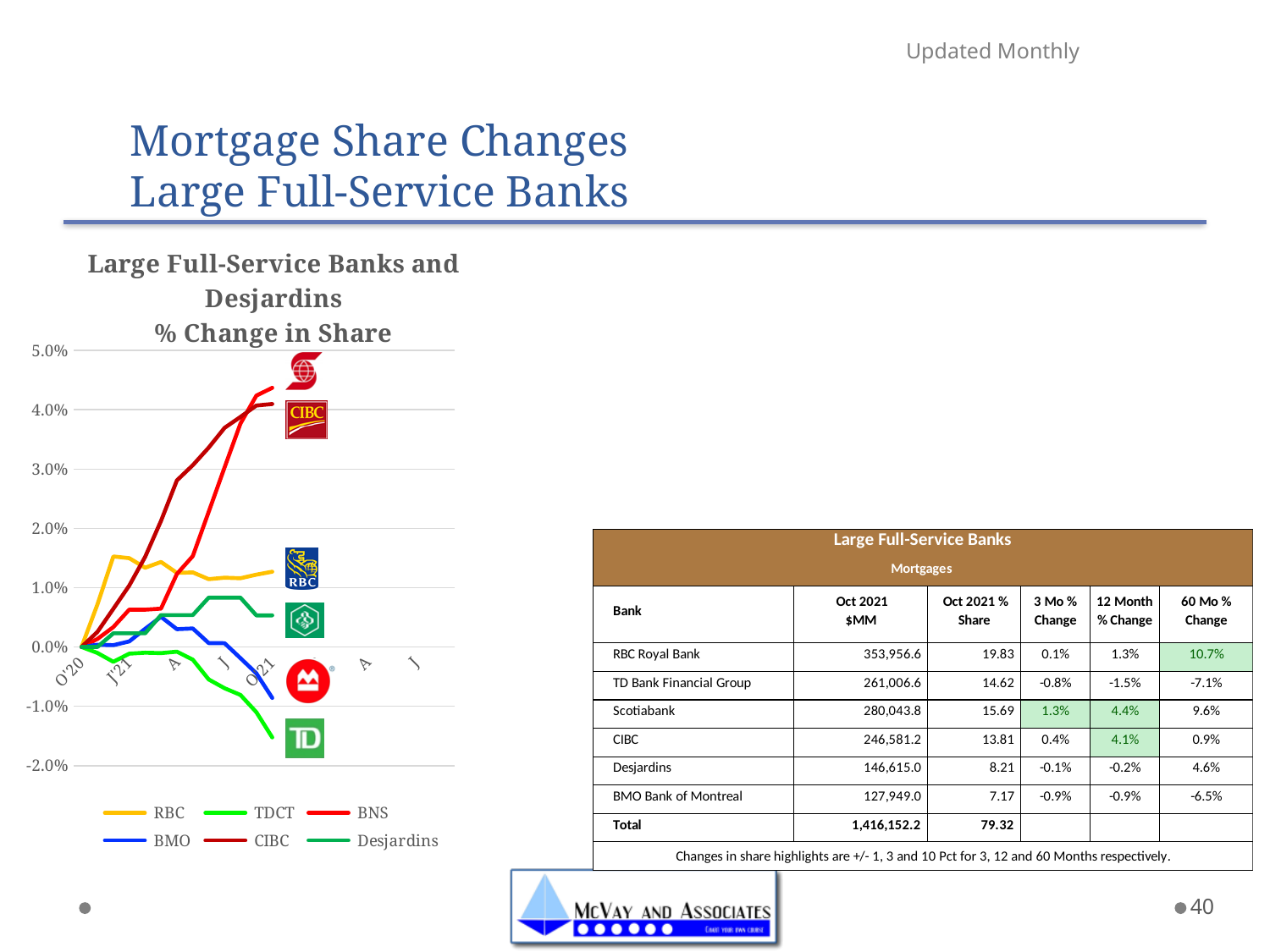
Is the final value for TDCT greater or less than -1.0%? less Is the final value for RBC greater or less than 1.0%? greater What kind of chart is shown on the slide? line chart How many series does the chart legend list? 6 Which series ends lowest at the right end of the chart? TDCT Does the TDCT line generally rise or fall across the chart? fall Is the final value for BMO greater or less than 0.0%? less What is the title of the chart? Large Full-Service Banks and Desjardins % Change in Share At the right end of the chart, which is higher: RBC or Desjardins? RBC What is the highest value shown on the chart's vertical axis? 5.0%